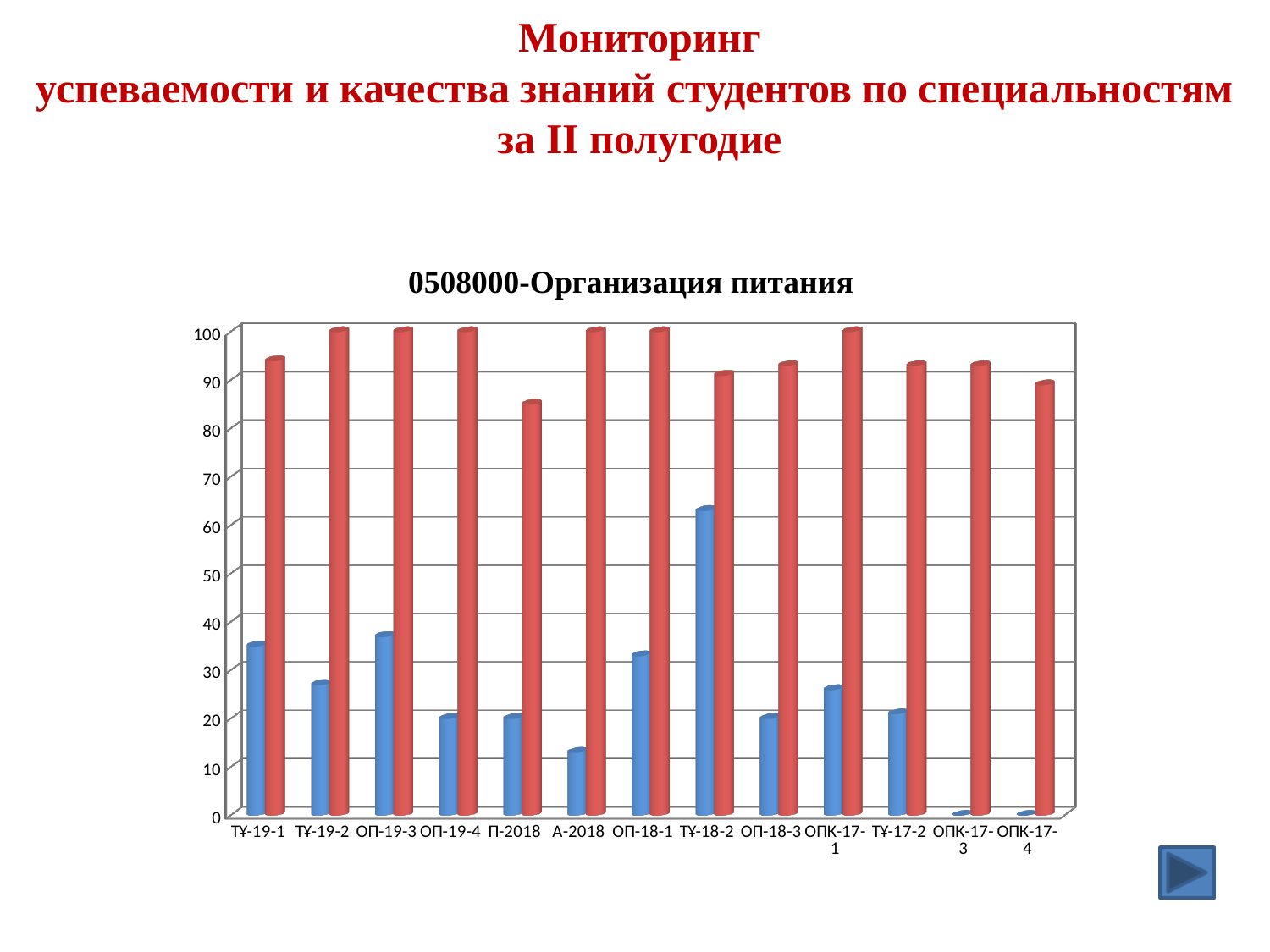
Which category has the highest blue bar? ТҰ-18-2 How many categories (groups) are shown on the x axis of the chart? 13 Which category has the lowest red bar? П-2018 Is the red bar for ТҮ-19-1 greater or less than 90? greater Which is larger, the red bar for ТҮ-19-2 or the red bar for П-2018? ТҰ-19-2 Which is larger, the blue bar for ОП-19-3 or the blue bar for ОП-19-4? ОП-19-3 Is the red bar for П-2018 greater or less than 90? less What is the maximum value shown on the vertical axis of the chart? 100 Is the blue bar for А-2018 greater or less than 20? less What is the title of the chart on the slide? 0508000-Организация питания What kind of chart is shown on the slide? bar chart